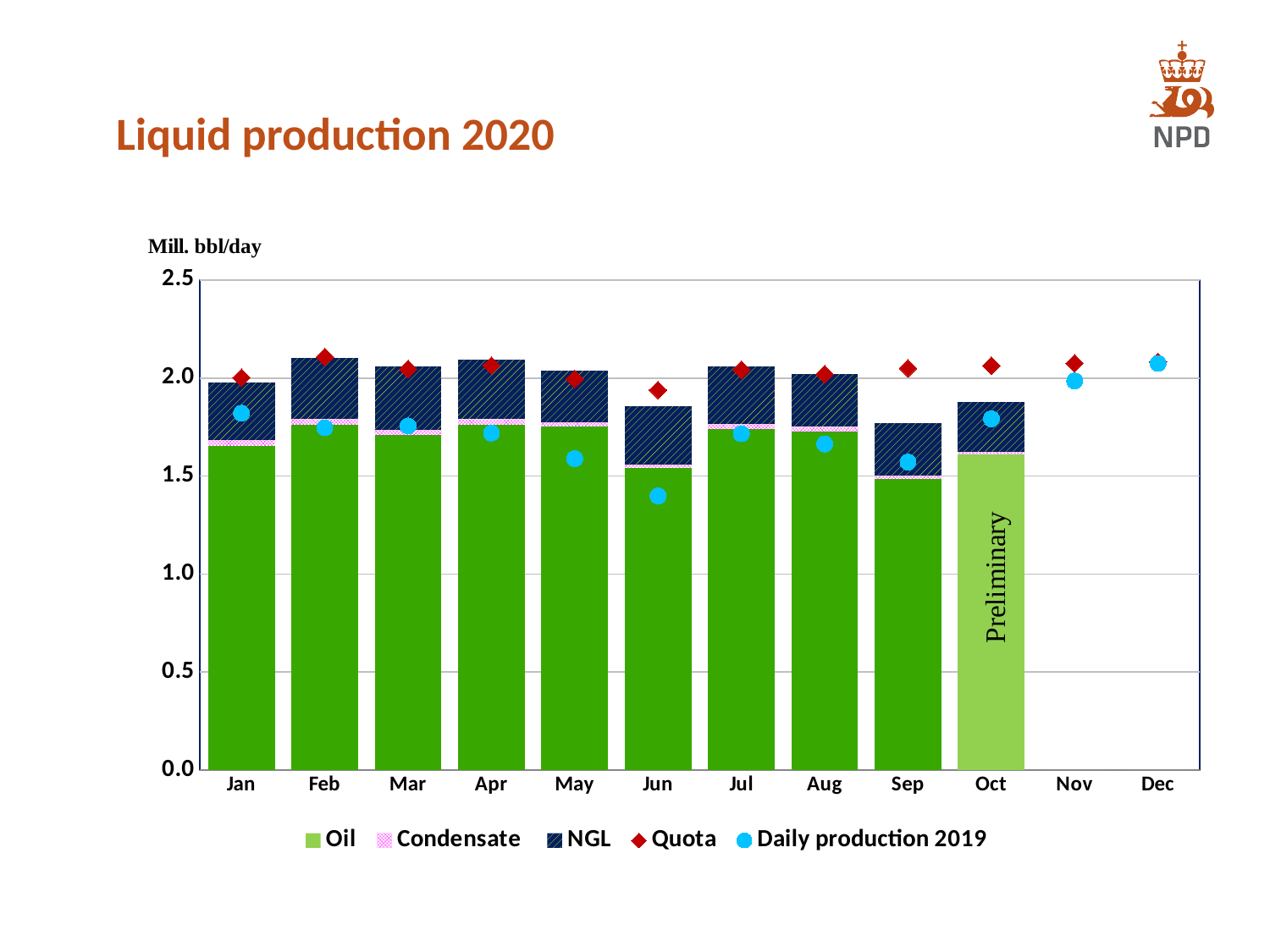
Which month has the highest total stacked bar? Feb Which month's bar is marked as Preliminary? Oct Which month has the lowest Daily production 2019 marker? Jun Is the Daily production 2019 value for Jun greater or less than 1.5? less Which month has the lowest Quota marker? Jun How many months have a stacked production bar? 10 How many months are labelled on the x axis? 12 How many series does the legend list? 5 What kind of chart is shown on the slide? Stacked bar chart with line/marker series Is the total stacked bar for Feb greater or less than 2.0? greater Is the Oil value for Jan greater or less than 1.5? greater Which is larger, the total stacked bar for Feb or for Jun? Feb